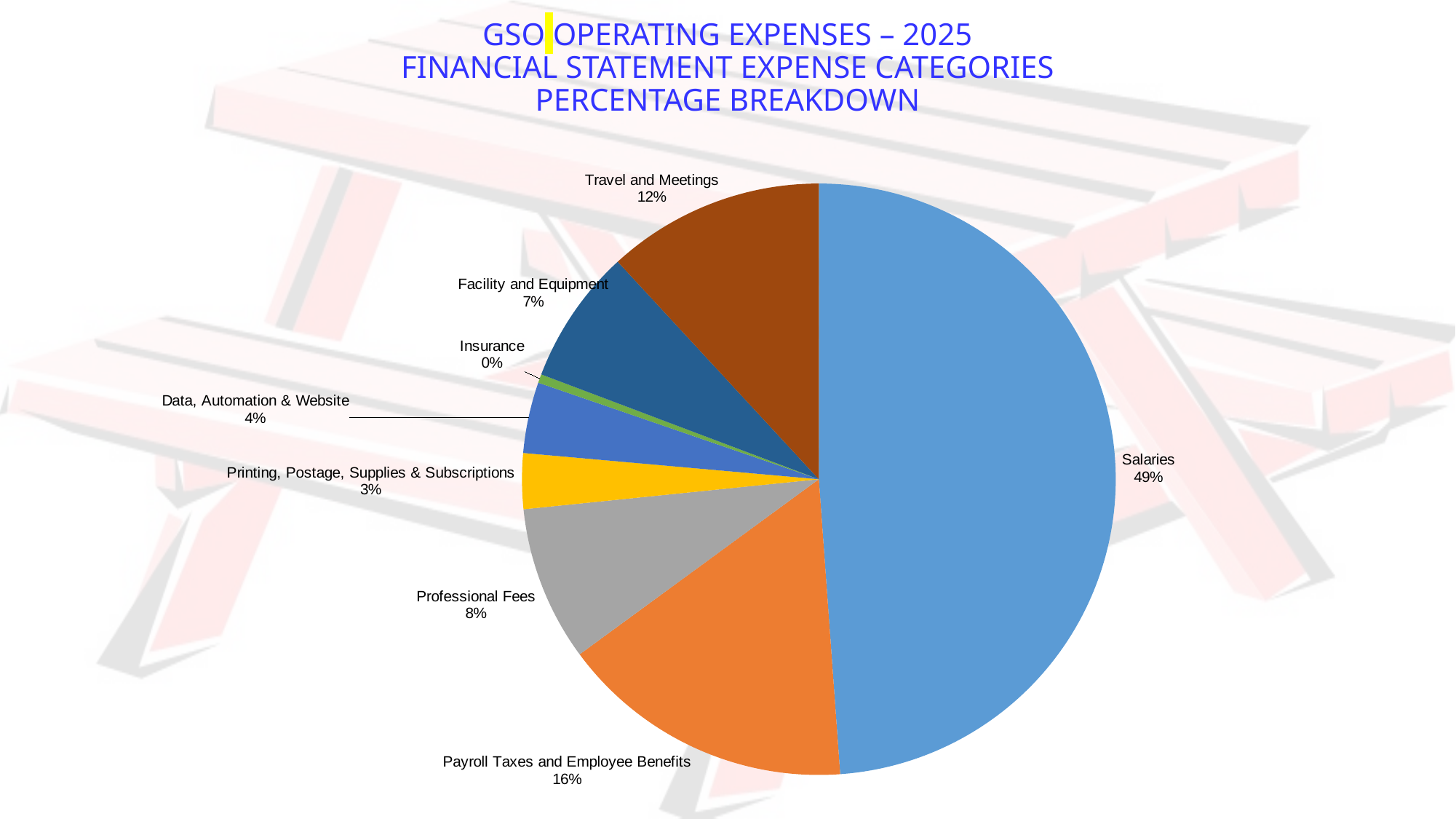
What percentage of operating expenses is Salaries? 49% What percentage is shown for Data, Automation & Website? 4% What year does the chart title refer to? 2025 Which expense category has the smallest share of the pie? Insurance What is the combined percentage of Travel and Meetings and Facility and Equipment? 19% Which is larger, Professional Fees or Facility and Equipment? Professional Fees What is the difference in percentage points between Salaries and Payroll Taxes and Employee Benefits? 33 How many expense categories are shown in the pie chart? 8 What kind of chart is shown on the slide? pie chart What percentage is shown for Travel and Meetings? 12% Which expense category has the largest share of the pie? Salaries What percentage is shown for Payroll Taxes and Employee Benefits? 16%